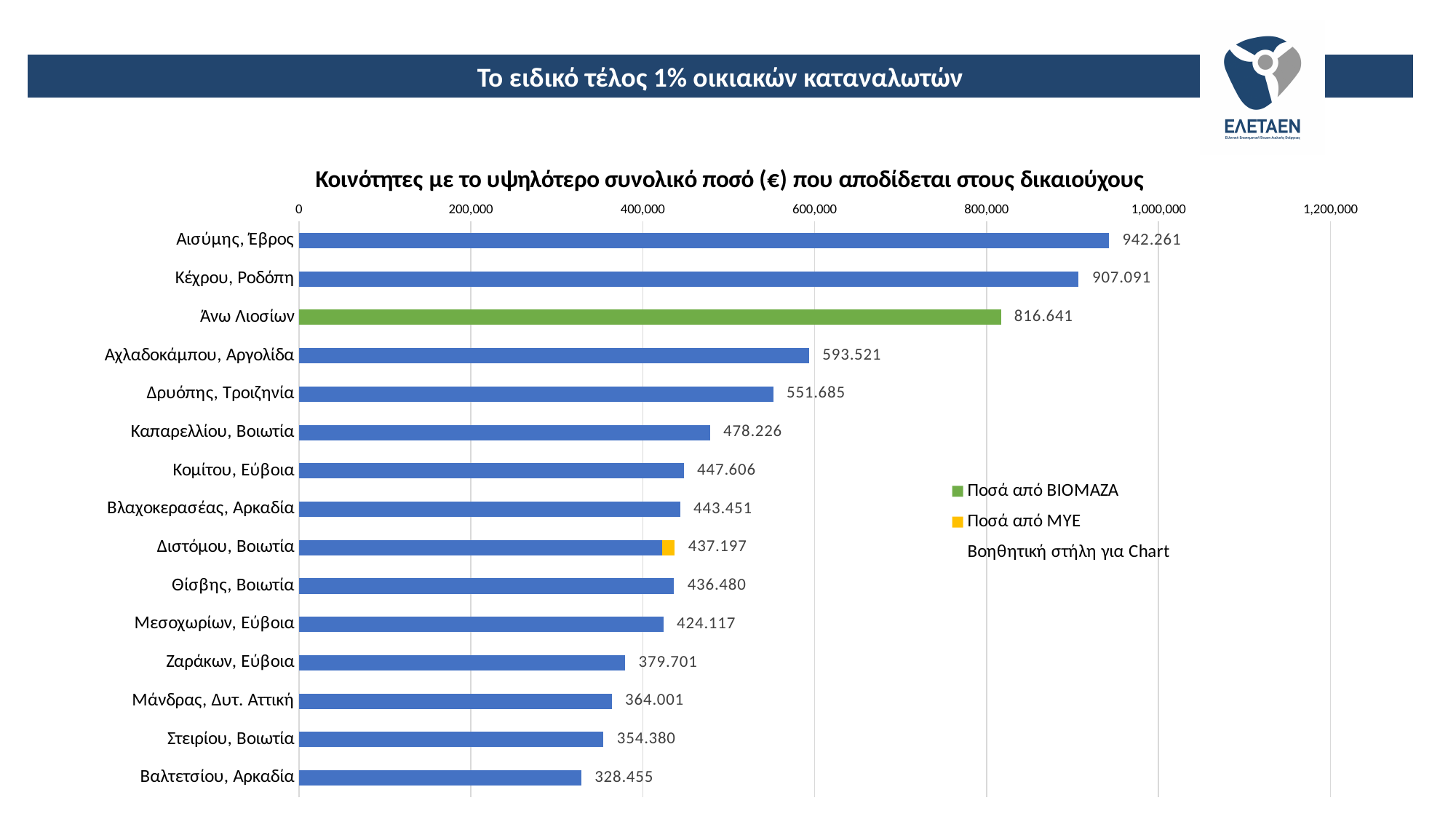
Which is larger, the value for Κομίτου, Εύβοια or the value for Βλαχοκερασέας, Αρκαδία? Κομίτου, Εύβοια Is the value for Άνω Λιοσίων greater or less than 800,000? greater What is the value shown for Διστόμου, Βοιωτία? 437.197 Which community's bar is coloured green? Άνω Λιοσίων How many communities are listed in the chart? 15 What is the value shown for Αισύμης, Έβρος? 942.261 What kind of chart is shown on the slide? bar chart How many entries does the chart legend list? 3 Which community has the highest total amount in the chart? Αισύμης, Έβρος What is the difference between the values for Αισύμης, Έβρος and Κέχρου, Ροδόπη? 35.170 Which community has the lowest total amount in the chart? Βαλτετσίου, Αρκαδία What is the value shown for Μάνδρας, Δυτ. Αττική? 364.001